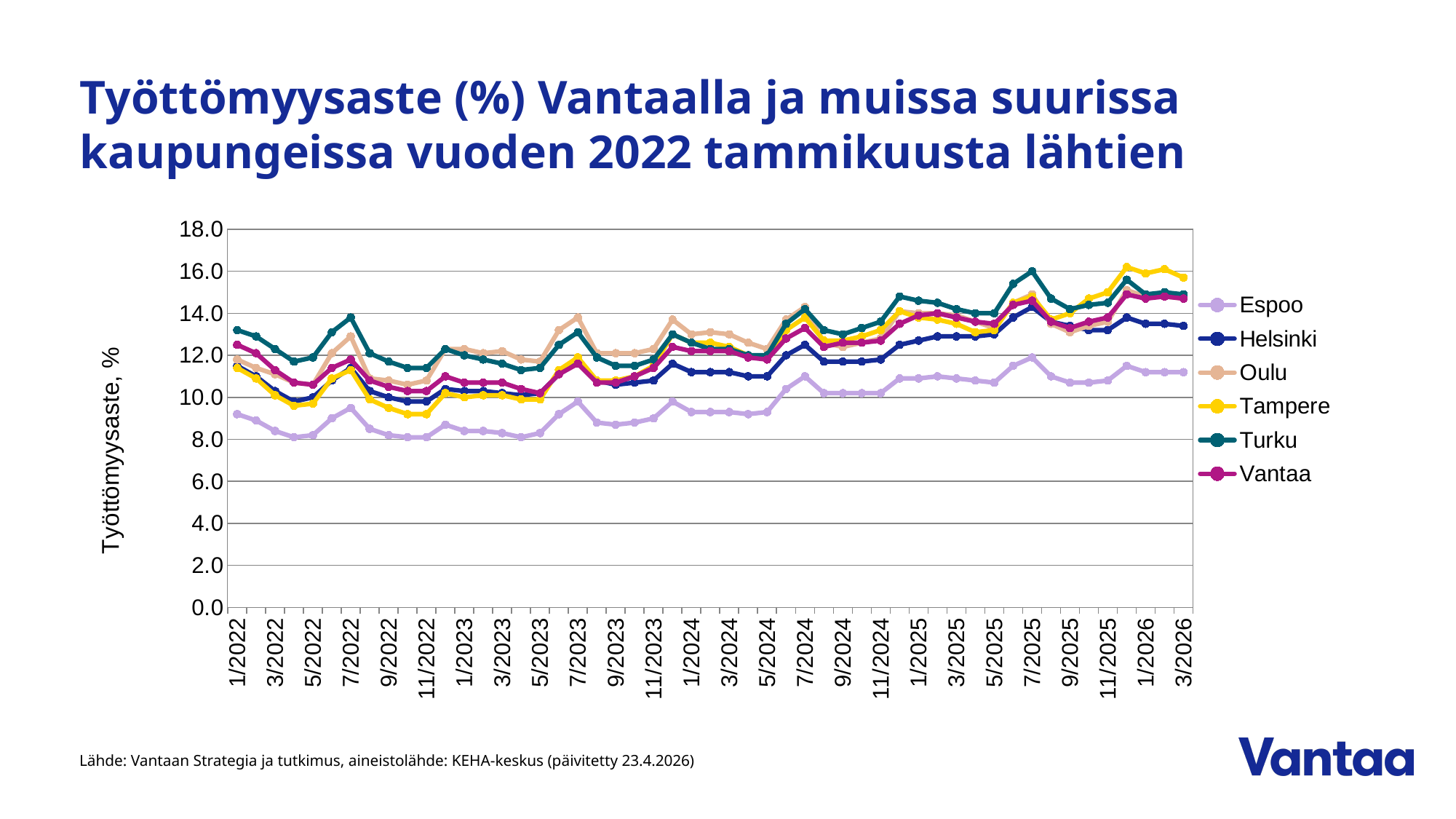
What kind of chart is shown on the slide? line chart Which is larger at 1/2022, the value for Espoo or the value for Turku? Turku Which series has the lowest unemployment rate across the whole period? Espoo Which city has the highest unemployment rate at 1/2022? Turku What is the title of the chart? Työttömyysaste (%) Vantaalla ja muissa suurissa kaupungeissa vuoden 2022 tammikuusta lähtien Is the value for Turku at 1/2022 greater or less than 12? greater Is the value for Espoo at 1/2022 greater or less than 10? less Does the unemployment rate for Espoo rise or fall overall from 1/2022 to 3/2026? rise Is the value for Vantaa at 3/2026 greater or less than 14? greater What is the label of the vertical axis? Työttömyysaste, % Which city has the highest unemployment rate at 3/2026? Tampere How many series does the legend list? 6